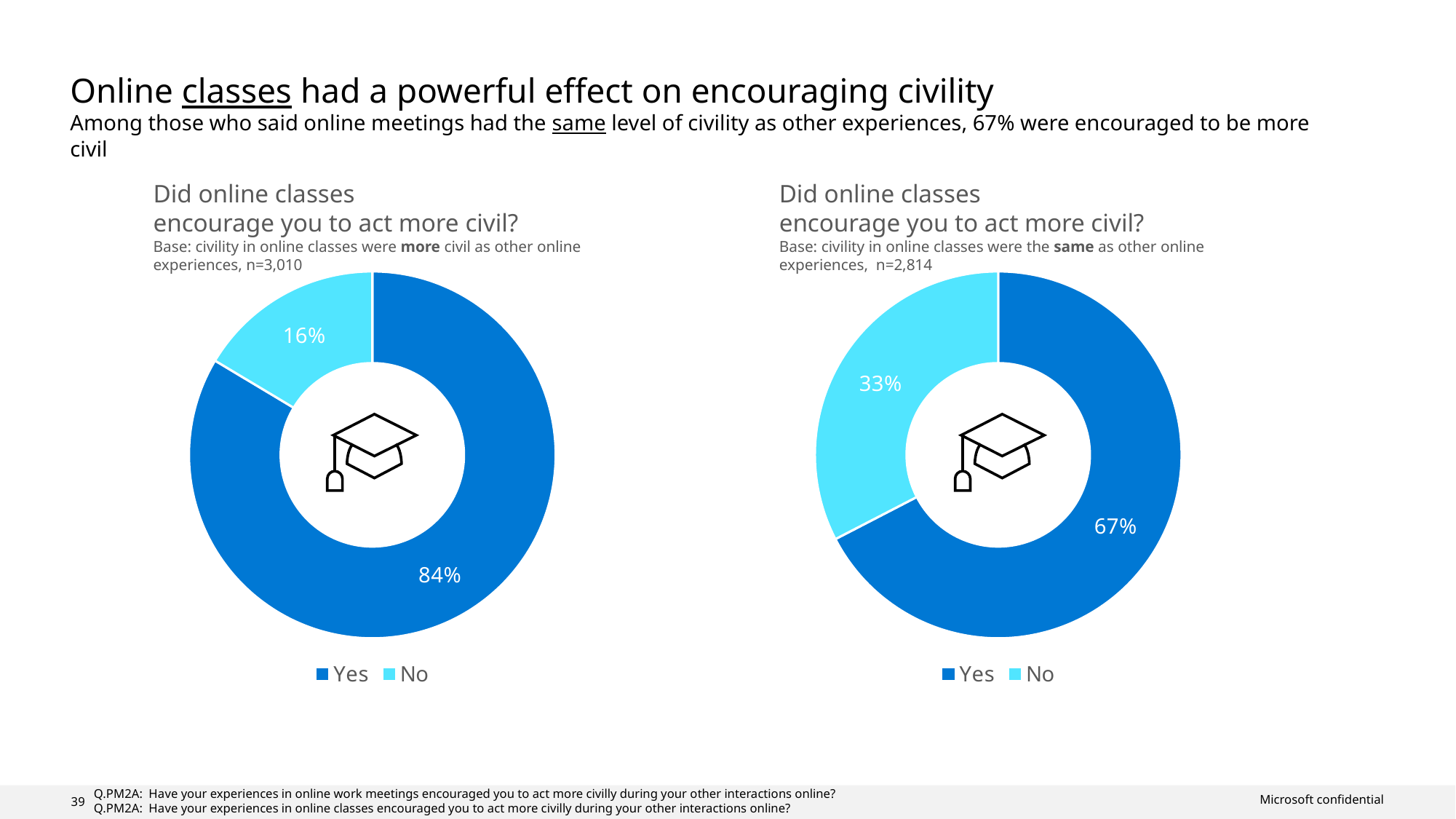
In the right chart (base: online classes were the same as other online experiences, n=2,814), what percentage answered No? 33% In the left chart (base: online classes were more civil, n=3,010), what percentage answered Yes? 84% In the right chart (n=2,814), what is the difference in percentage points between Yes and No? 34 In the right chart (n=2,814), which response has the smaller share? No In the right chart (base: online classes were the same as other online experiences, n=2,814), what percentage answered Yes? 67% What type of chart is used on this slide? Pie chart (donut) In the left chart (base: online classes were more civil, n=3,010), what percentage answered No? 16% In the left chart (n=3,010), which response has the larger share, Yes or No? Yes In the left chart (n=3,010), what is the difference in percentage points between Yes and No? 68 How many entries does the legend of the left chart list? 2 What is the difference in percentage points between the Yes share in the left chart and the Yes share in the right chart? 17 What is the sample size (n) stated for the right chart? n=2,814